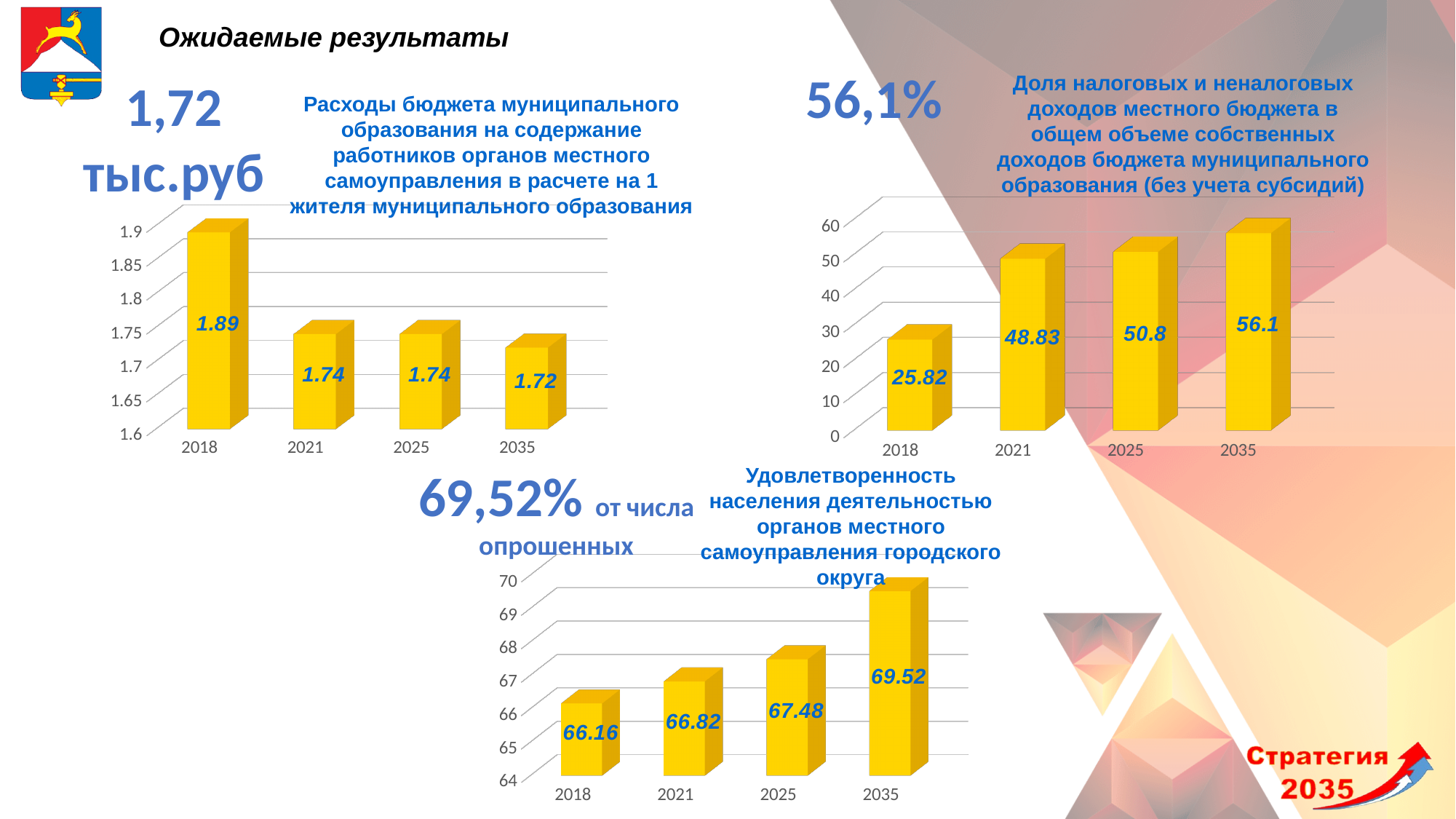
In the bottom chart (population satisfaction with local self-government), which is larger, the value for 2021 or the value for 2035? 2035 In the top-right chart (share of tax and non-tax revenues in own budget revenues), do the values rise or fall from 2018 to 2035? rise In the bottom chart (population satisfaction with local self-government), how many years are plotted? 4 What type of chart is the bottom chart (population satisfaction with local self-government)? bar chart In the top-left chart (budget expenses on local self-government staff per resident), what is the value for 2035? 1.72 In the top-right chart (share of tax and non-tax revenues in own budget revenues), which year has the lowest value? 2018 In the top-left chart (budget expenses on local self-government staff per resident), which year has the highest value? 2018 In the top-right chart (share of tax and non-tax revenues in own budget revenues), what is the difference between the 2035 and 2018 values? 30.28 In the top-left chart (budget expenses on local self-government staff per resident), what is the difference between the 2018 and 2035 values? 0.17 In the top-left chart (budget expenses on local self-government staff per resident), what is the value for 2018? 1.89 In the top-right chart (share of tax and non-tax revenues in own budget revenues), what is the value for 2021? 48.83 In the bottom chart (population satisfaction with local self-government), what is the value for 2025? 67.48